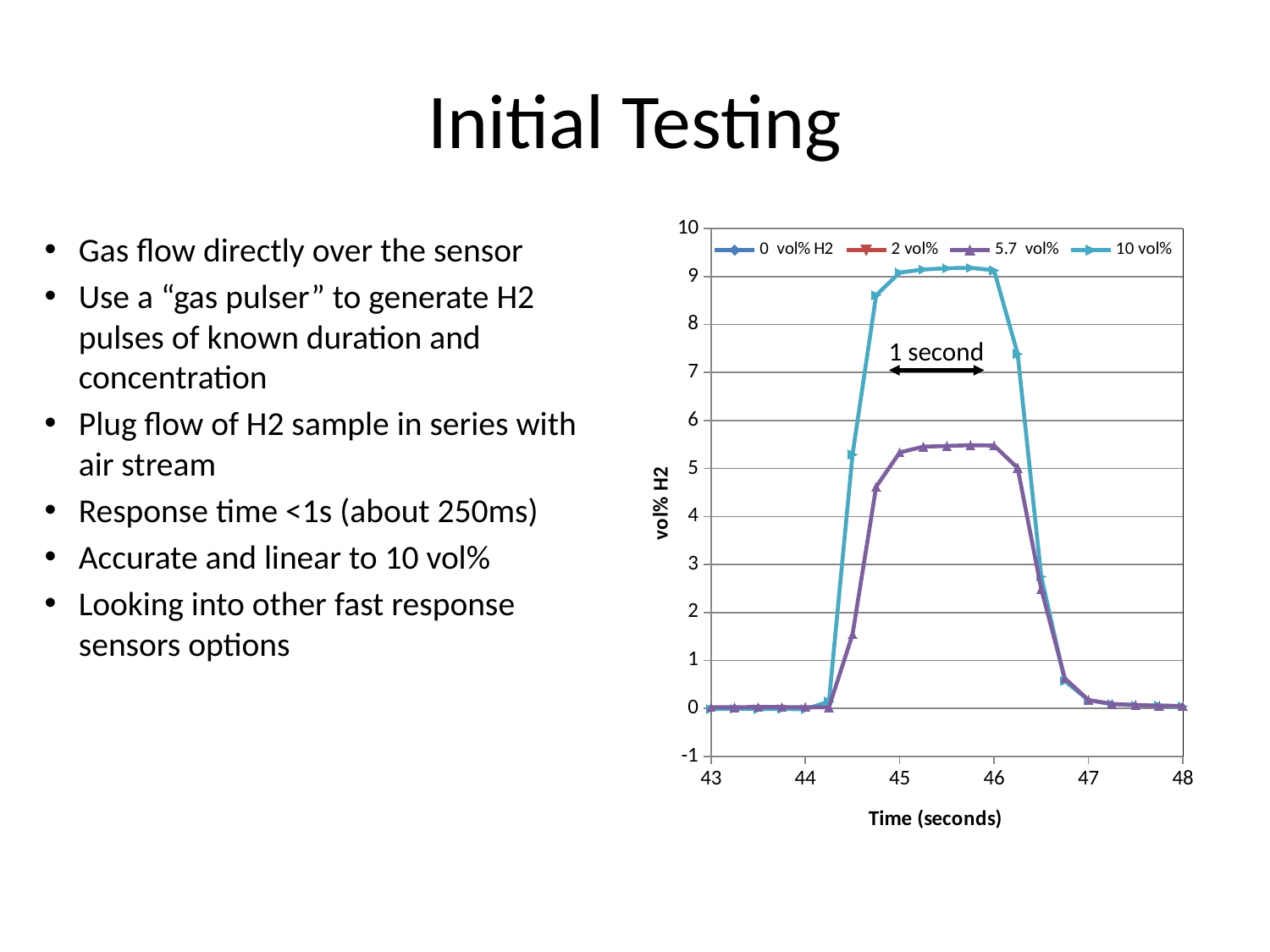
Is the value of the 10 vol% series at 47.5 seconds greater or less than 1? less How many series does the chart legend list? 4 What is the label of the x axis of the chart? Time (seconds) At time 45.5 seconds, which series has the higher value, 10 vol% or 5.7 vol%? 10 vol% Between 44 and 45 seconds, does the 10 vol% series rise or fall? rise Is the peak value of the 5.7 vol% series greater or less than 5? greater What kind of chart is shown on the slide? line chart Is the peak value of the 5.7 vol% series greater or less than 6? less What is the label of the y axis of the chart? vol% H2 Between 46 and 47 seconds, does the 5.7 vol% series rise or fall? fall